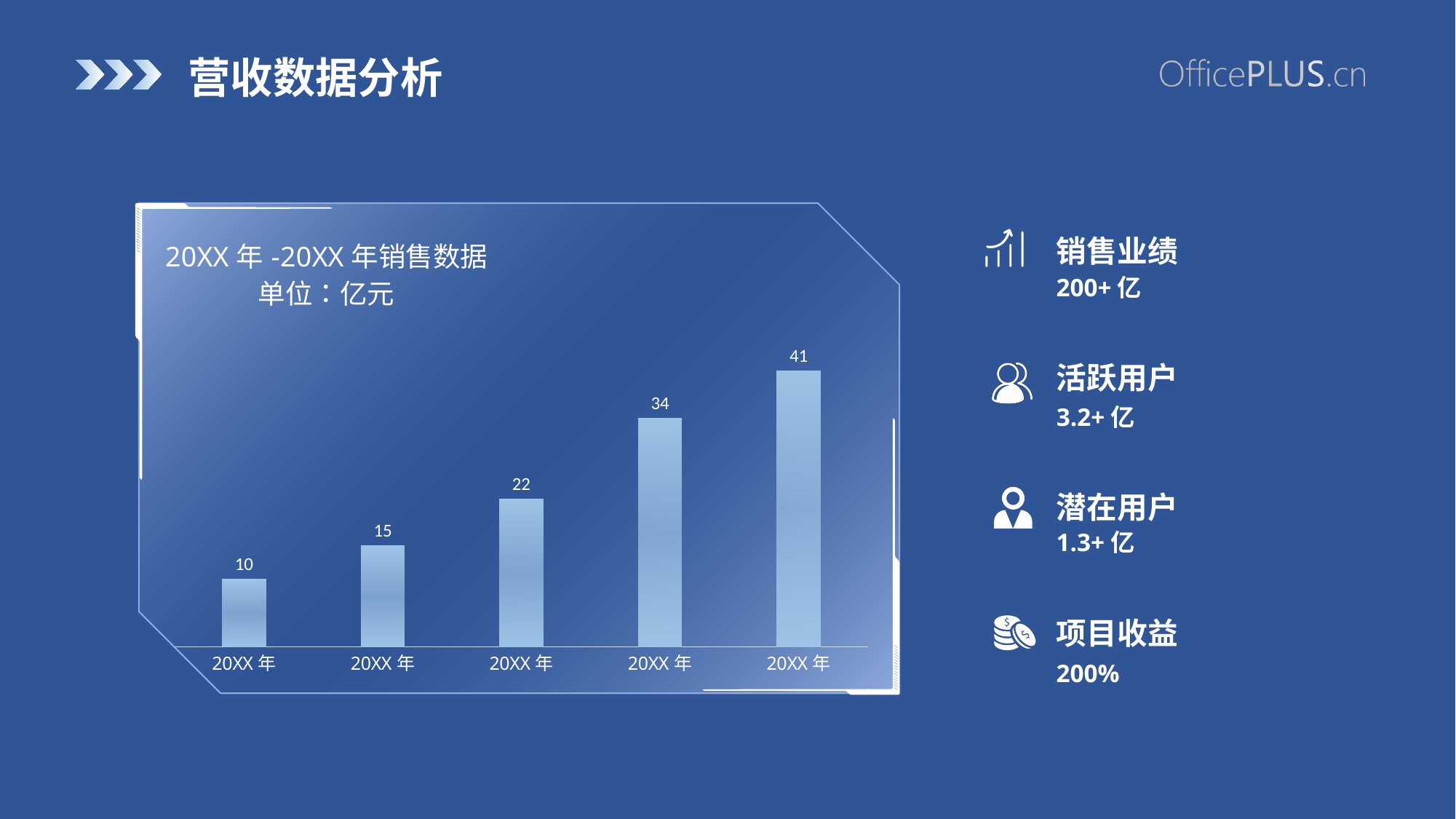
How many bars does the chart contain? 5 What is the value of the last (rightmost) bar in the chart? 41 What is the value of the fourth bar in the chart? 34 Do the values rise or fall from left to right across the chart? rise What is the value of the first (leftmost) bar in the chart? 10 What is the highest value shown in the chart? 41 What type of chart is shown on the slide? bar chart Which is larger, the second bar or the third bar? the third bar (22) What is the lowest value shown in the chart? 10 What is the value of the third bar in the chart? 22 What unit is stated for the chart's values? 亿元 What is the difference between the fifth bar (41) and the fourth bar (34)? 7